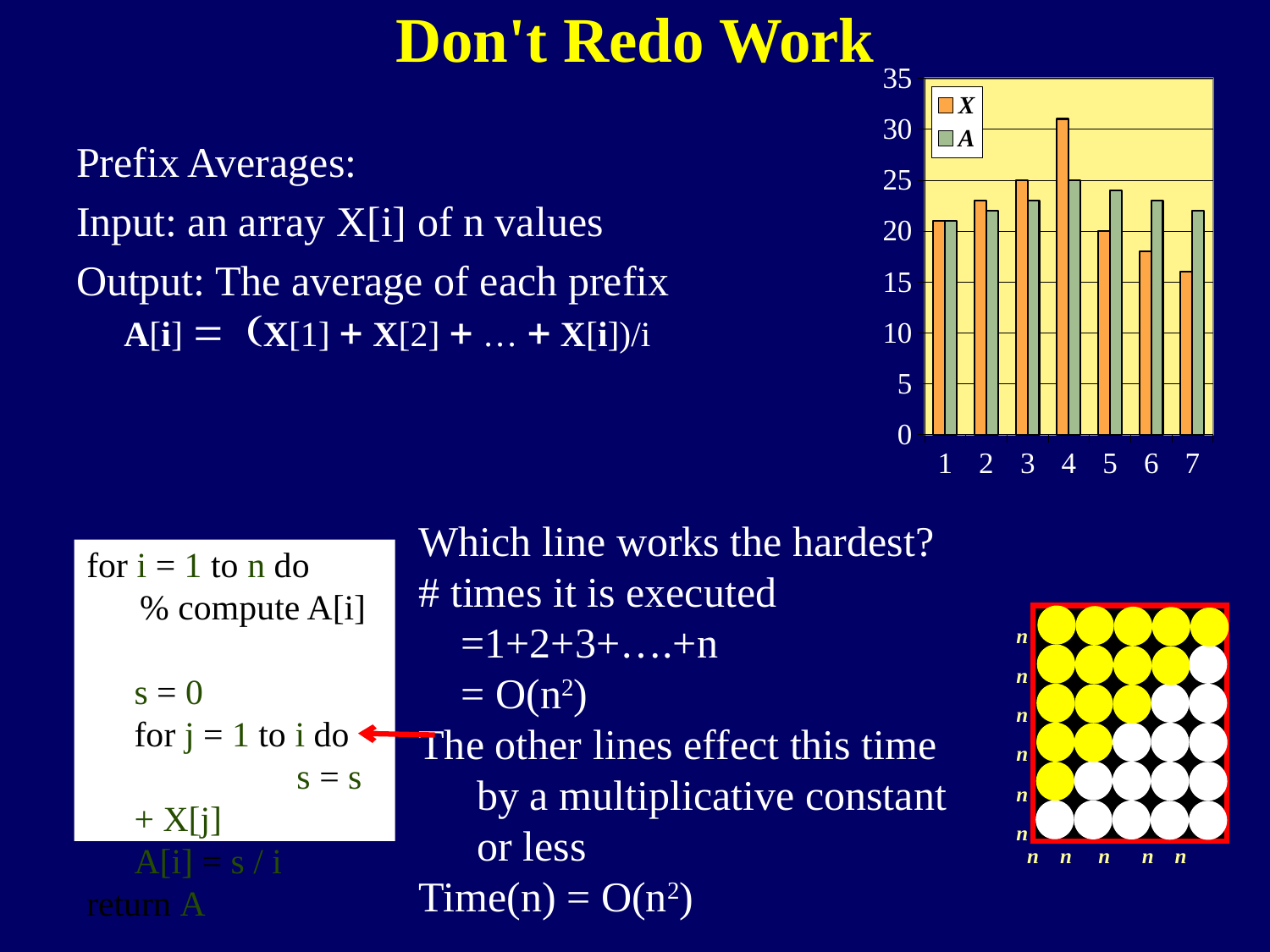
Which series are listed in the chart's legend? X and A What kind of chart is shown on the slide? bar chart Is the value of A for category 4 greater or less than 20? greater For which category is the X series highest? 4 Is the value of X for category 7 greater or less than 20? less How many series does the chart's legend list? 2 For category 4, which series has the larger value, X or A? X For category 7, which series has the larger value, X or A? A How many categories are shown along the x axis of the chart? 7 Do the values of the X series rise or fall from category 4 to category 7? fall For which category is the X series lowest? 7 Is the value of X for category 4 greater or less than 25? greater